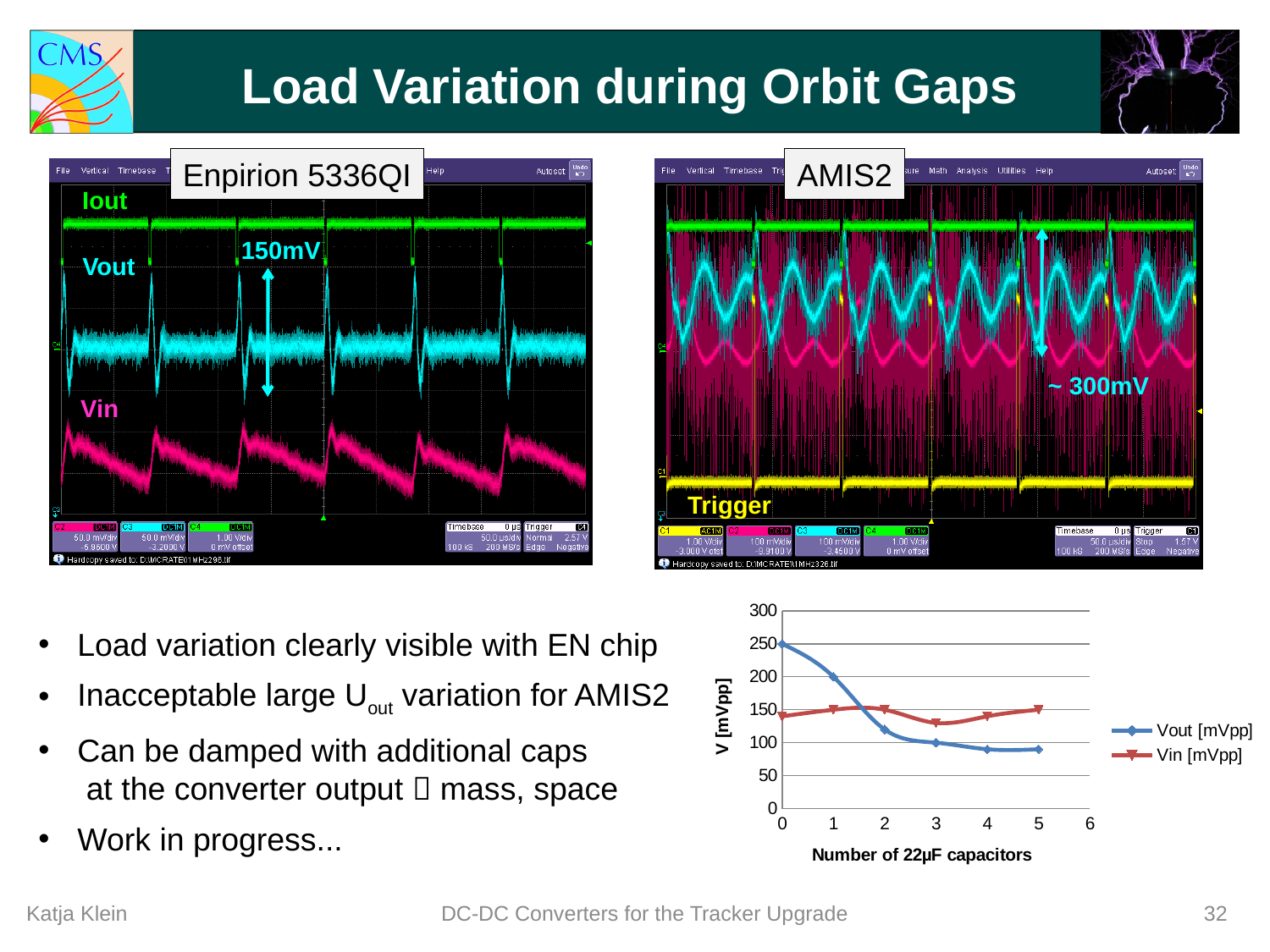
In the line chart at the bottom right, what are the two series named in the legend? Vout [mVpp] and Vin [mVpp] In the line chart at the bottom right, which series has the larger value at 5 capacitors, Vout [mVpp] or Vin [mVpp]? Vin [mVpp] What kind of chart is shown at the bottom right of the slide? line chart In the line chart at the bottom right, is the Vout [mVpp] value at 4 capacitors greater or less than 100? less In the line chart at the bottom right, is the Vin [mVpp] value at 2 capacitors greater or less than 100? greater In the line chart at the bottom right, how many series does the legend list? 2 In the line chart at the bottom right, which series has the larger value at 0 capacitors, Vout [mVpp] or Vin [mVpp]? Vout [mVpp] In the line chart at the bottom right, is the Vout [mVpp] value at 2 capacitors greater or less than 150? less In the line chart at the bottom right, does Vout [mVpp] rise or fall as the number of capacitors increases? fall In the line chart at the bottom right, what is the title of the x axis? Number of 22µF capacitors In the line chart at the bottom right, how many data points does the Vout [mVpp] series have? 6 In the line chart at the bottom right, what is the Vout [mVpp] value at 0 capacitors? 250